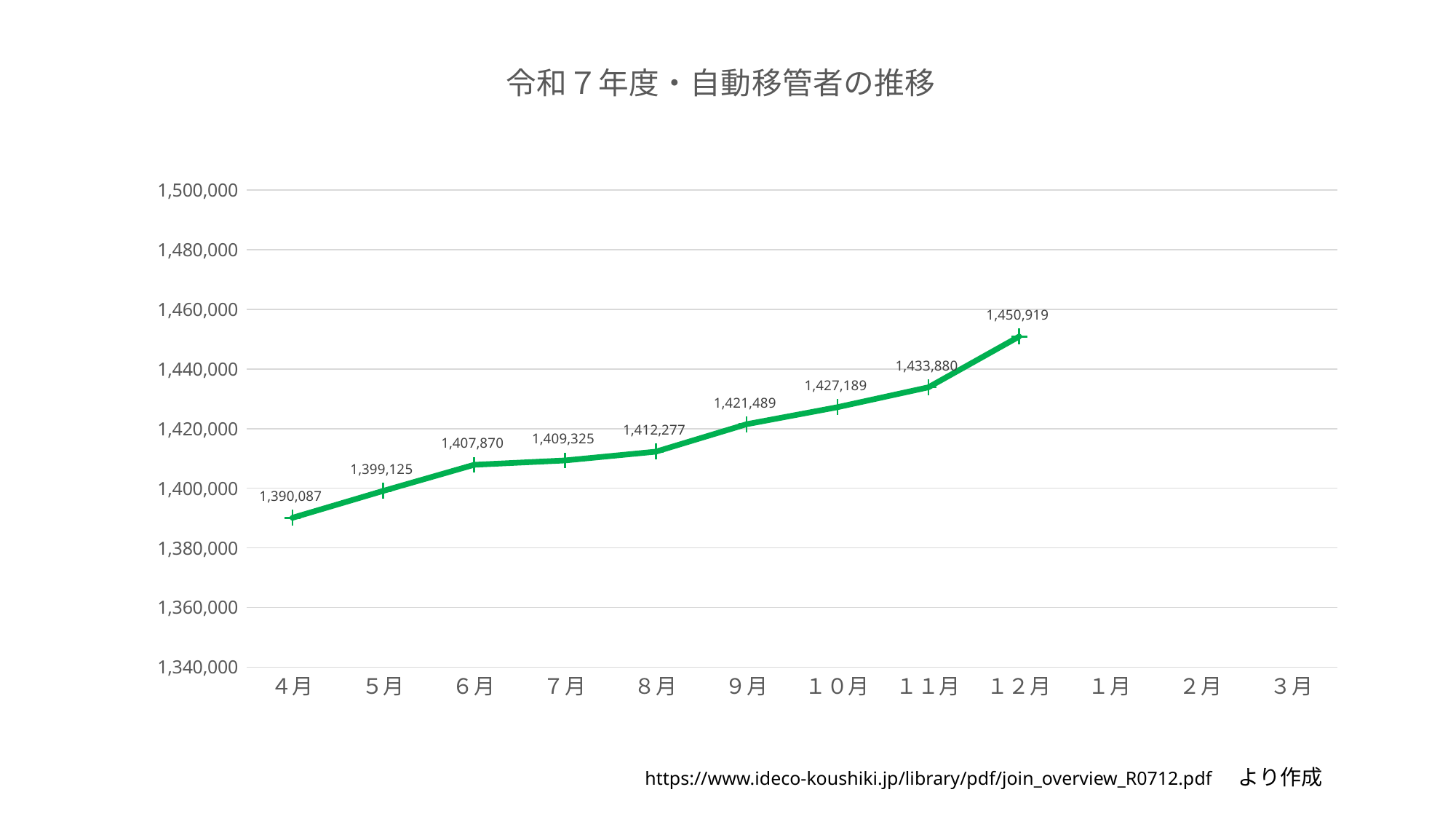
Which month has the lowest plotted value? 4月 What is the value for 4月? 1,390,087 Which is larger, the value for 9月 or the value for 7月? 9月 What is the value for 8月? 1,412,277 Do the values rise or fall from 4月 to 12月? rise What type of chart is shown on the slide? line chart How many data points are plotted on the line? 9 Which month has the highest plotted value? 12月 What is the difference between the values for 12月 and 11月? 17,039 What is the value for 12月? 1,450,919 What is the difference between the values for 5月 and 4月? 9,038 What is the value for 10月? 1,427,189